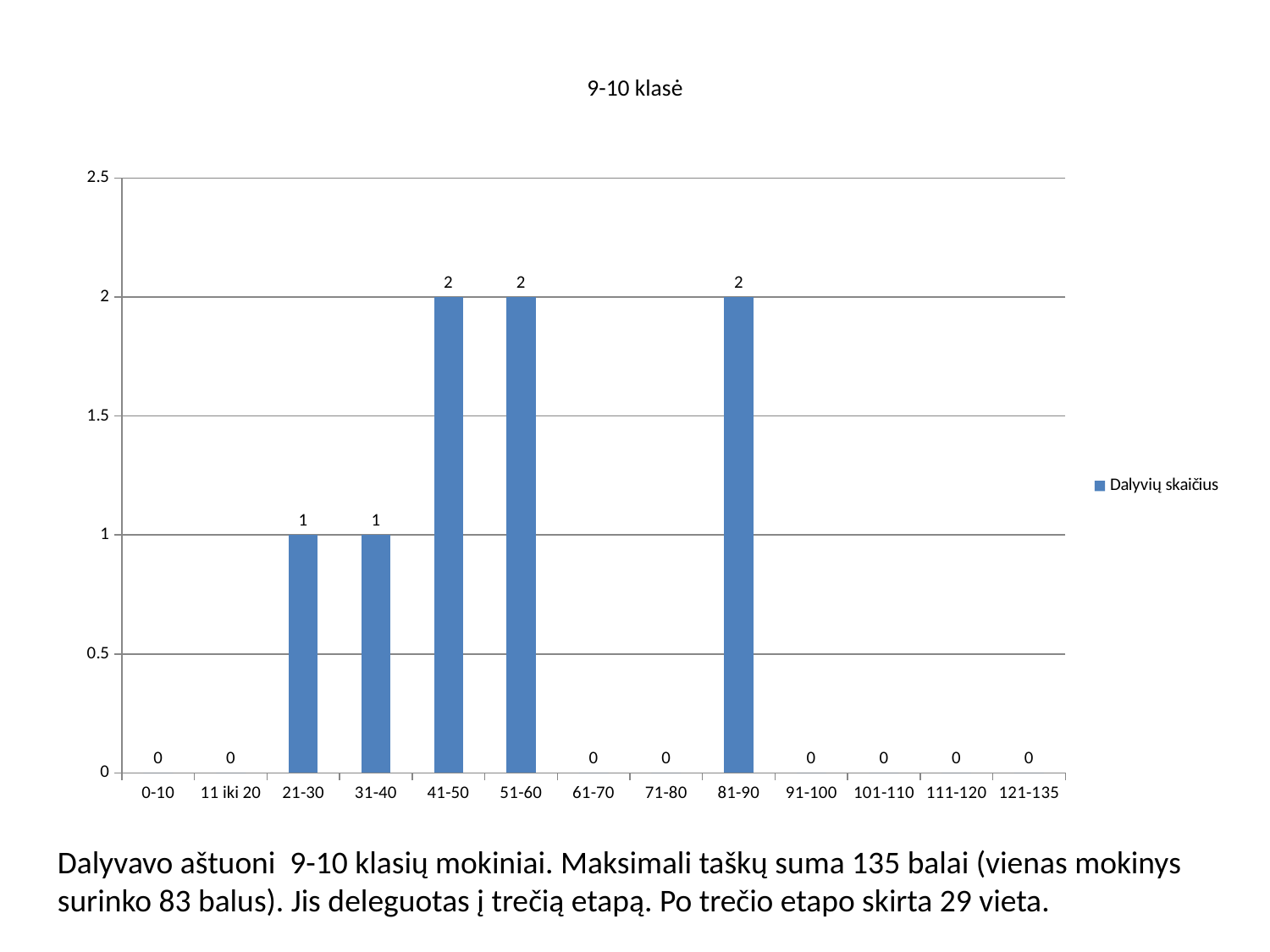
What is the value for the 31-40 category? 1 What is the value for the 81-90 category? 2 What type of chart is shown on the slide? Bar chart What is the value for the 41-50 category? 2 What is the value for the 21-30 category? 1 What is the value for the 61-70 category? 0 How many series does the legend list? 1 Which is larger, the value for 41-50 or the value for 21-30? 41-50 How many categories are shown on the x axis? 13 How many categories have a value of 2? 3 Which is larger, the value for 31-40 or the value for 71-80? 31-40 What is the difference between the values for 51-60 and 31-40? 1